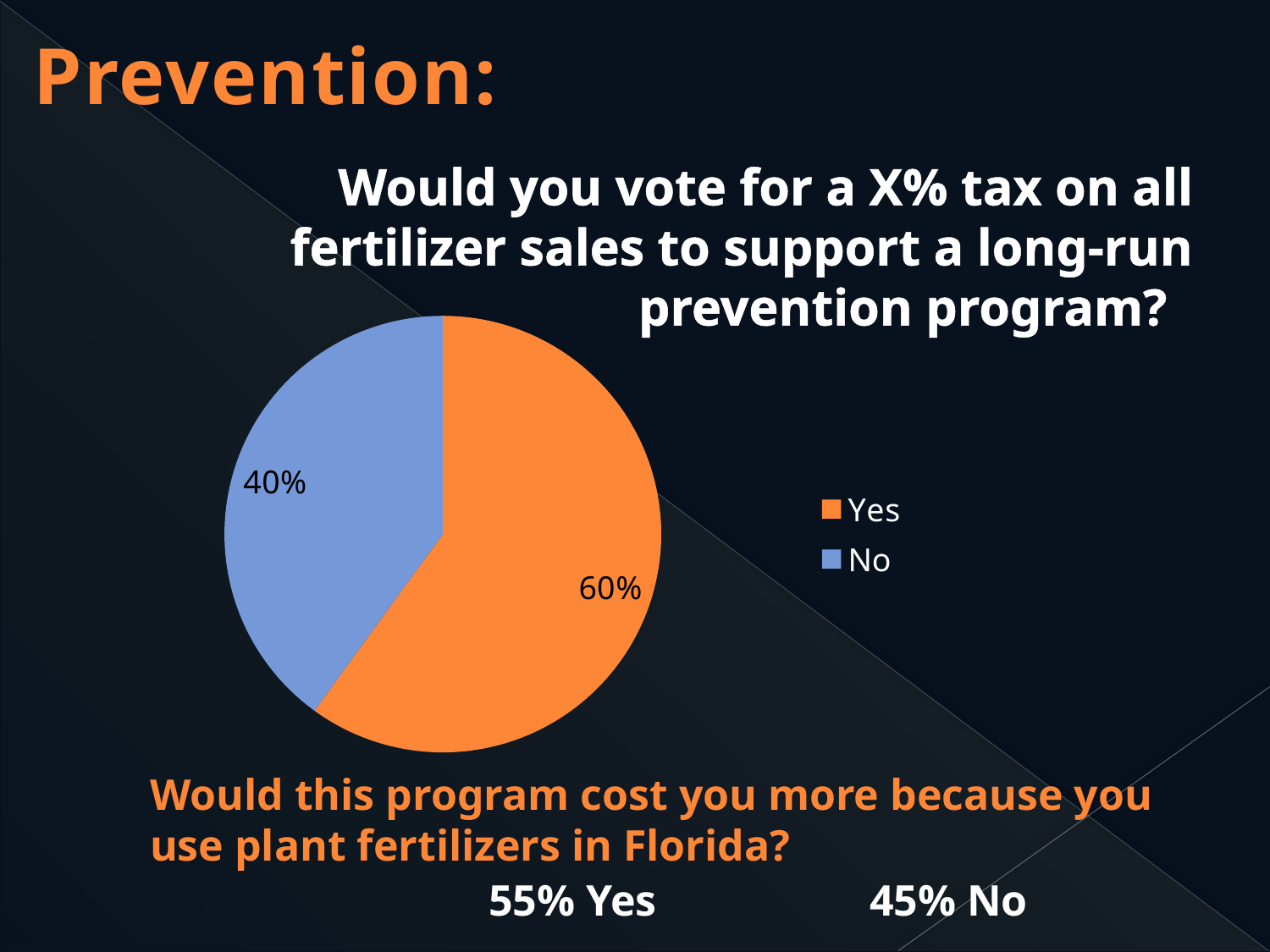
Which slice of the pie chart is the smallest? No Which slice of the pie chart is the largest? Yes What percentage of the pie chart is labelled No? 40% What kind of chart is shown on the slide? Pie chart What is the difference in percentage points between the Yes and No slices of the pie chart? 20 What colour is the Yes slice in the pie chart? Orange How many entries does the pie chart's legend list? 2 Which is larger in the pie chart, Yes or No? Yes How many slices does the pie chart have? 2 What share of the pie does the Yes slice represent? 60% What colour is the No slice in the pie chart? Blue What percentage of the pie chart is labelled Yes? 60%